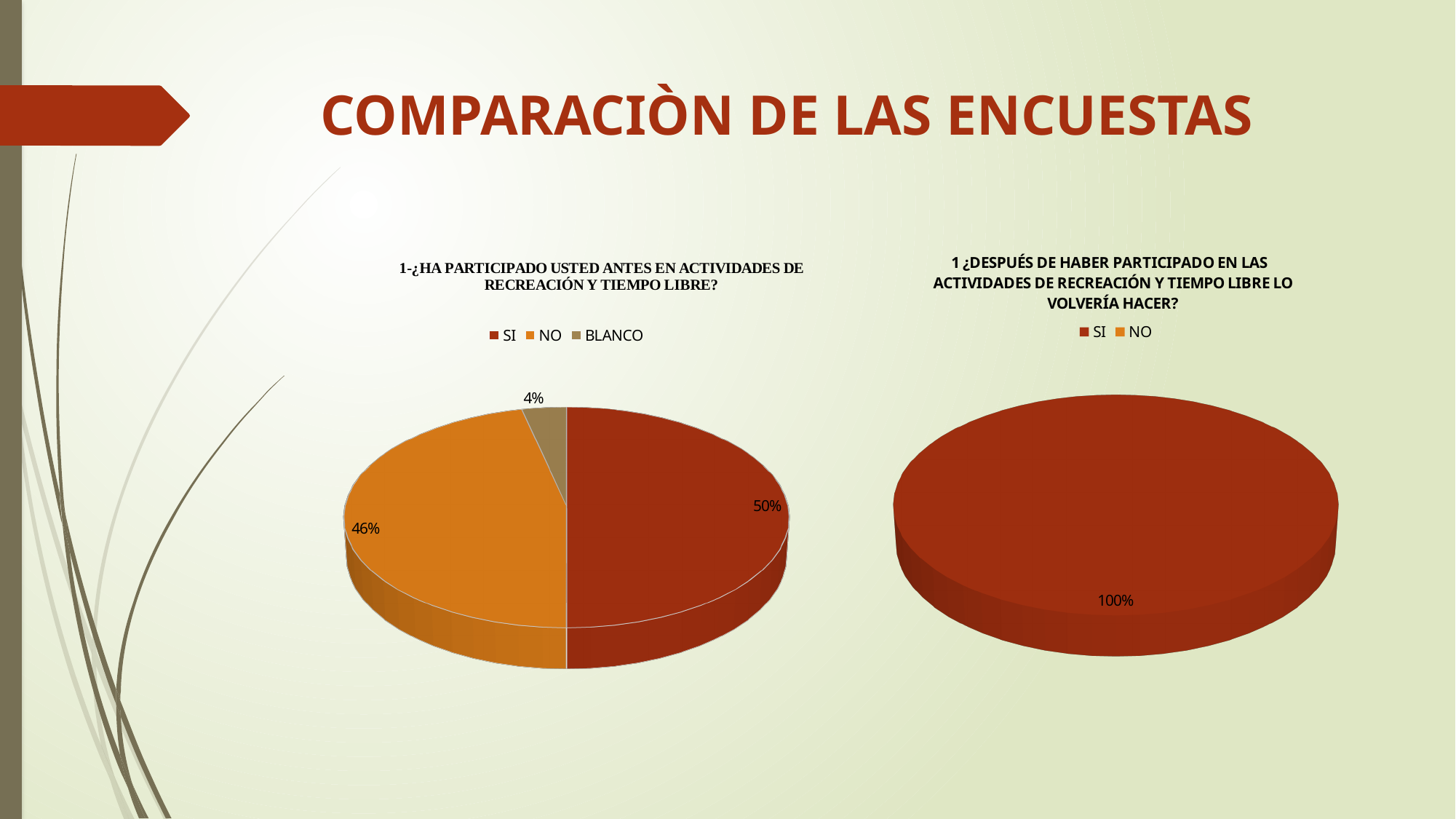
How many categories does the legend of the left chart list? 3 What is the title of the slide? COMPARACIÒN DE LAS ENCUESTAS In the left chart, which category has the largest slice? SI How many categories does the legend of the right chart list? 2 In the left chart, which is larger, NO or BLANCO? NO In the left chart, what share of the pie is NO? 46% In the left chart, what share of the pie is BLANCO? 4% In the left chart, what is the difference between the SI and NO shares? 4% In the right chart (¿DESPUÉS DE HABER PARTICIPADO ... LO VOLVERÍA HACER?), what share of the pie is SI? 100% What kind of chart is the right chart? Pie chart In the left chart (¿HA PARTICIPADO USTED ANTES EN ACTIVIDADES DE RECREACIÓN Y TIEMPO LIBRE?), what share of the pie is SI? 50% In the left chart, which category has the smallest slice? BLANCO